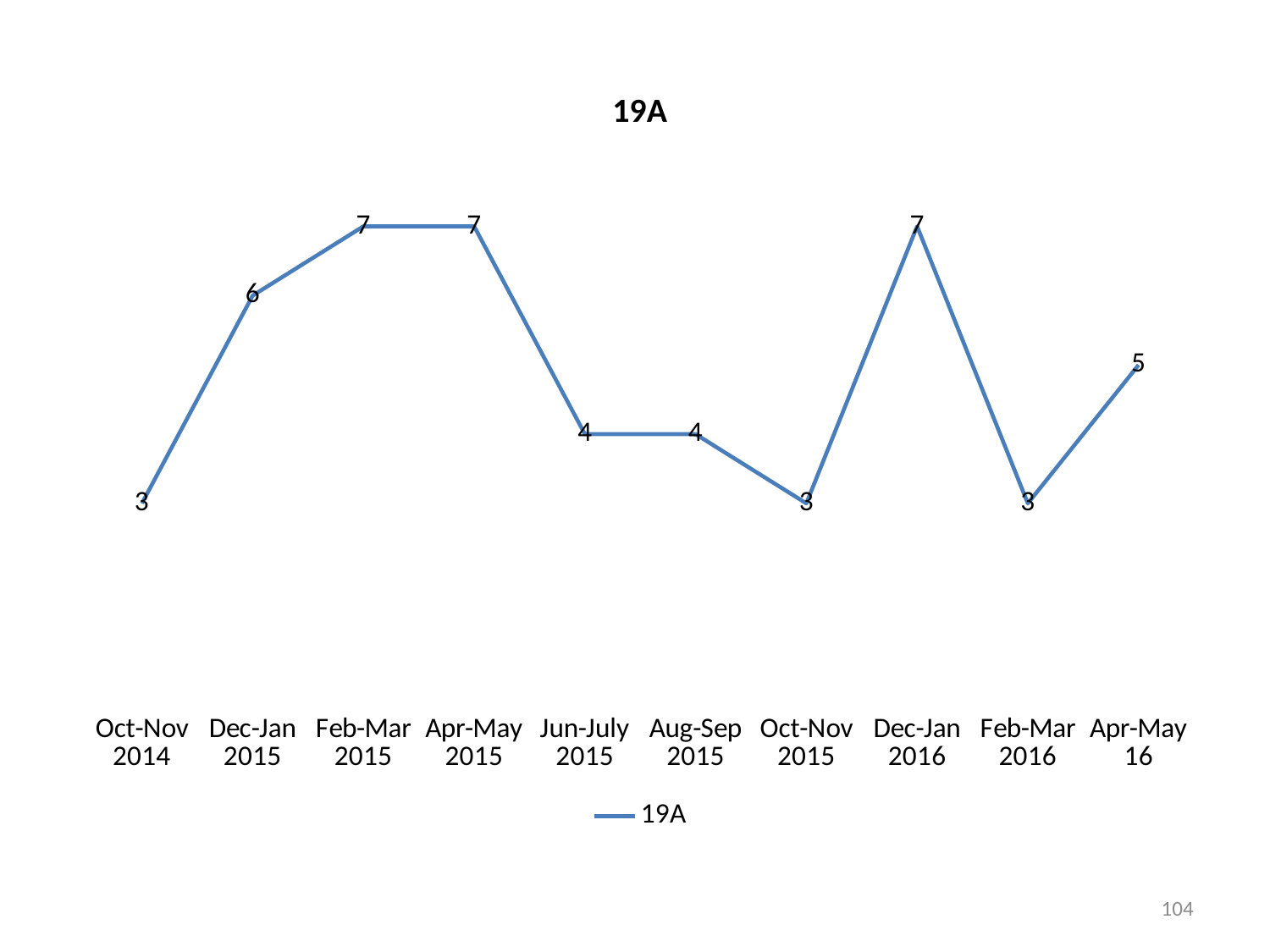
What is the lowest value plotted on the chart? 3 What is the value for Apr-May 16? 5 How many data points are plotted on the chart? 10 What kind of chart is shown on the slide? line chart What is the value for Jun-July 2015? 4 What is the title of the chart? 19A How many series does the legend list? 1 What is the value for Dec-Jan 2015? 6 Which is larger, the value for Dec-Jan 2015 or the value for Aug-Sep 2015? Dec-Jan 2015 What is the highest value plotted on the chart? 7 What is the difference between the values for Dec-Jan 2016 and Feb-Mar 2016? 4 What is the value for Oct-Nov 2015? 3